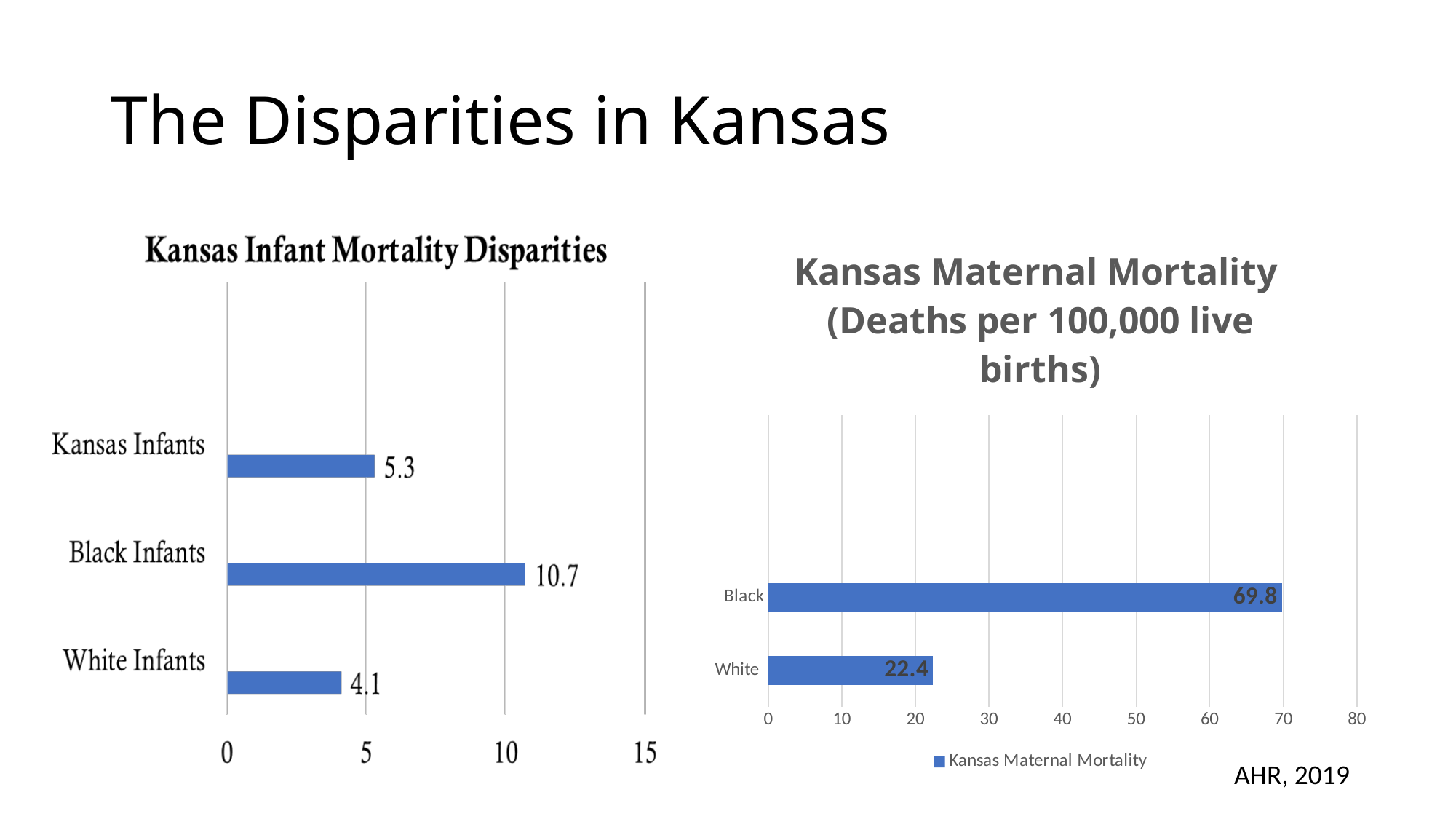
In the Kansas Infant Mortality Disparities chart, what is the value for White Infants? 4.1 In the Kansas Maternal Mortality chart, what is the value for Black? 69.8 What kind of chart is the Kansas Maternal Mortality chart? Bar chart In the Kansas Maternal Mortality chart, which is larger, the value for Black or the value for White? Black In the Kansas Infant Mortality Disparities chart, what is the value for Kansas Infants? 5.3 In the Kansas Infant Mortality Disparities chart, what is the value for Black Infants? 10.7 In the Kansas Infant Mortality Disparities chart, what is the difference between the values for Black Infants and White Infants? 6.6 In the Kansas Infant Mortality Disparities chart, which category has the highest value? Black Infants In the Kansas Infant Mortality Disparities chart, which category has the lowest value? White Infants In the Kansas Maternal Mortality chart, what is the value for White? 22.4 In the Kansas Infant Mortality Disparities chart, how many categories are shown? 3 In the Kansas Maternal Mortality chart, what is the difference between the values for Black and White? 47.4